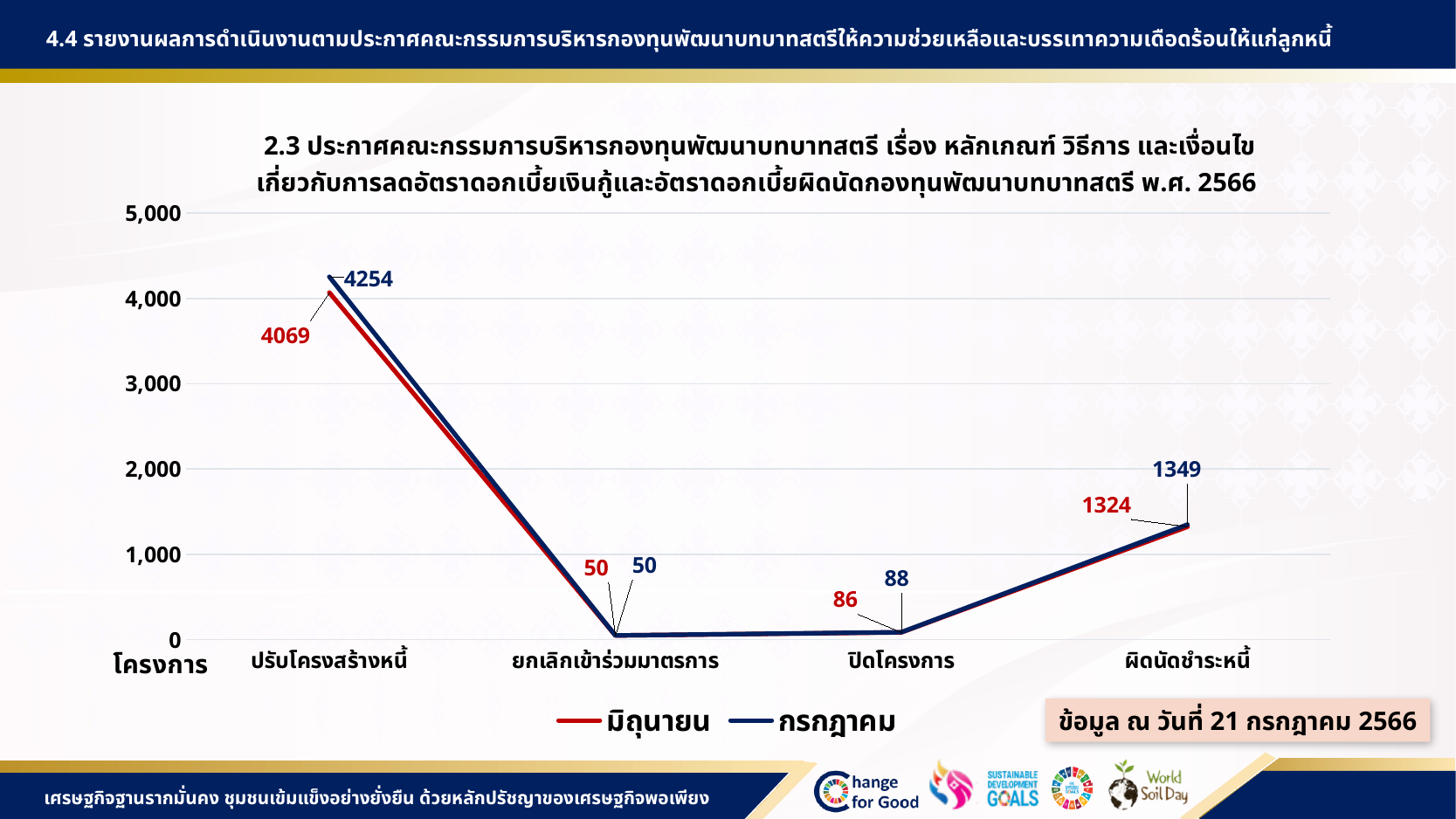
How many categories are shown on the x axis? 4 Which is larger for ผิดนัดชำระหนี้: the มิถุนายน value or the กรกฎาคม value? กรกฎาคม What is the value for ปิดโครงการ in the มิถุนายน series? 86 What is the value for ผิดนัดชำระหนี้ in the กรกฎาคม series? 1349 Which category has the highest value in the กรกฎาคม series? ปรับโครงสร้างหนี้ What type of chart is shown on the slide? line chart What is the value for ปรับโครงสร้างหนี้ in the กรกฎาคม series? 4254 Which series is drawn in red in the legend? มิถุนายน Which category has the lowest value in the มิถุนายน series? ยกเลิกเข้าร่วมมาตรการ How many series does the legend list? 2 What is the value for ปรับโครงสร้างหนี้ in the มิถุนายน series? 4069 What is the difference between the กรกฎาคม and มิถุนายน values for ปรับโครงสร้างหนี้? 185